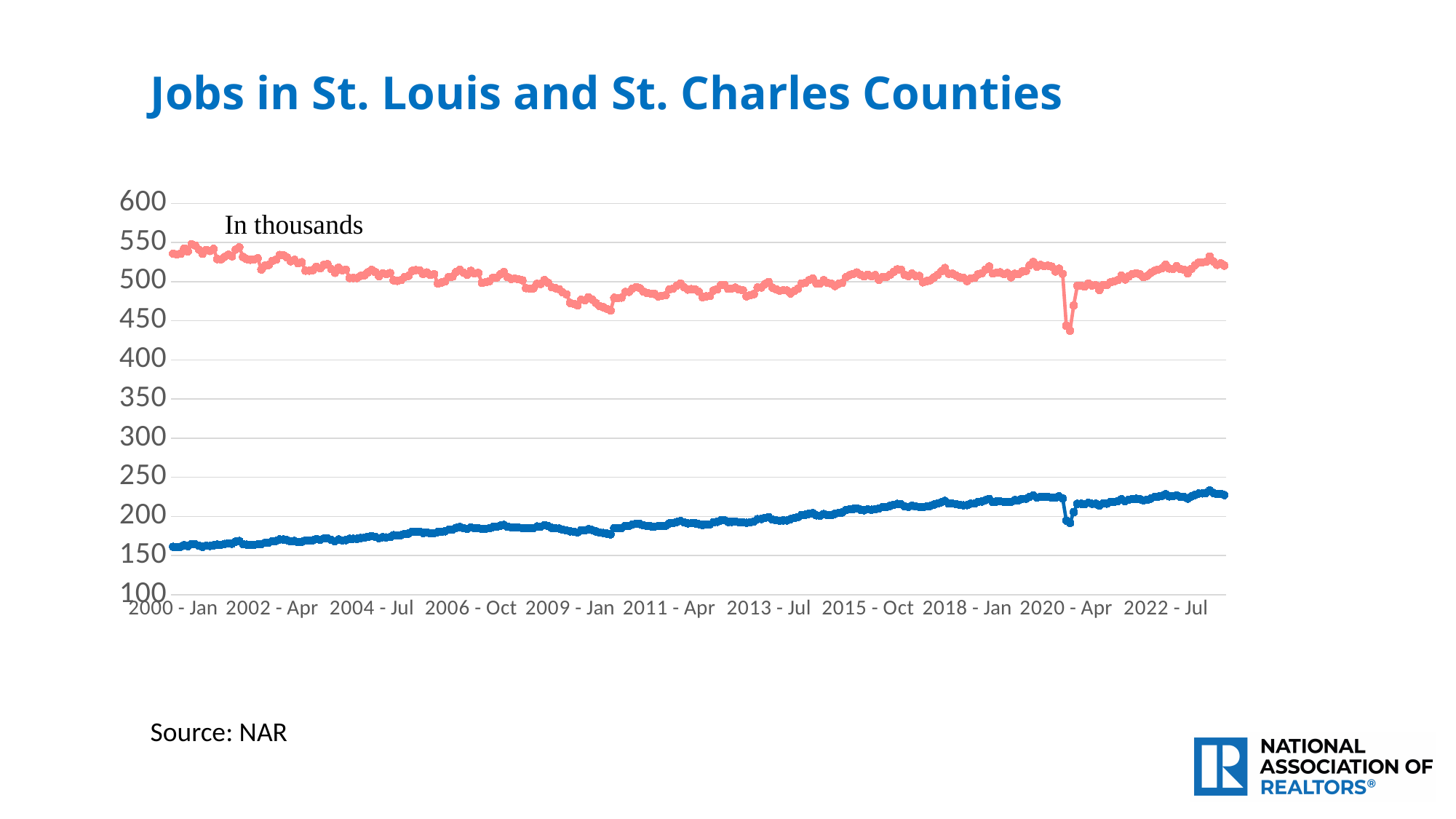
What kind of chart is shown on the slide? Line chart Is the lowest point of the pink line, around 2020, greater or less than 450? less What is the highest value shown on the vertical axis? 600 What is the title of the chart? Jobs in St. Louis and St. Charles Counties Which line is higher throughout the chart, the pink line or the blue line? The pink line Does the blue line generally rise or fall from 2000 to 2022? Rise Is the value of the blue line at 2000 - Jan greater or less than 200? less Is the value of the pink line at 2000 - Jan greater or less than 500? greater How many lines are plotted on the chart? 2 In what units are the values plotted, according to the note on the chart? In thousands